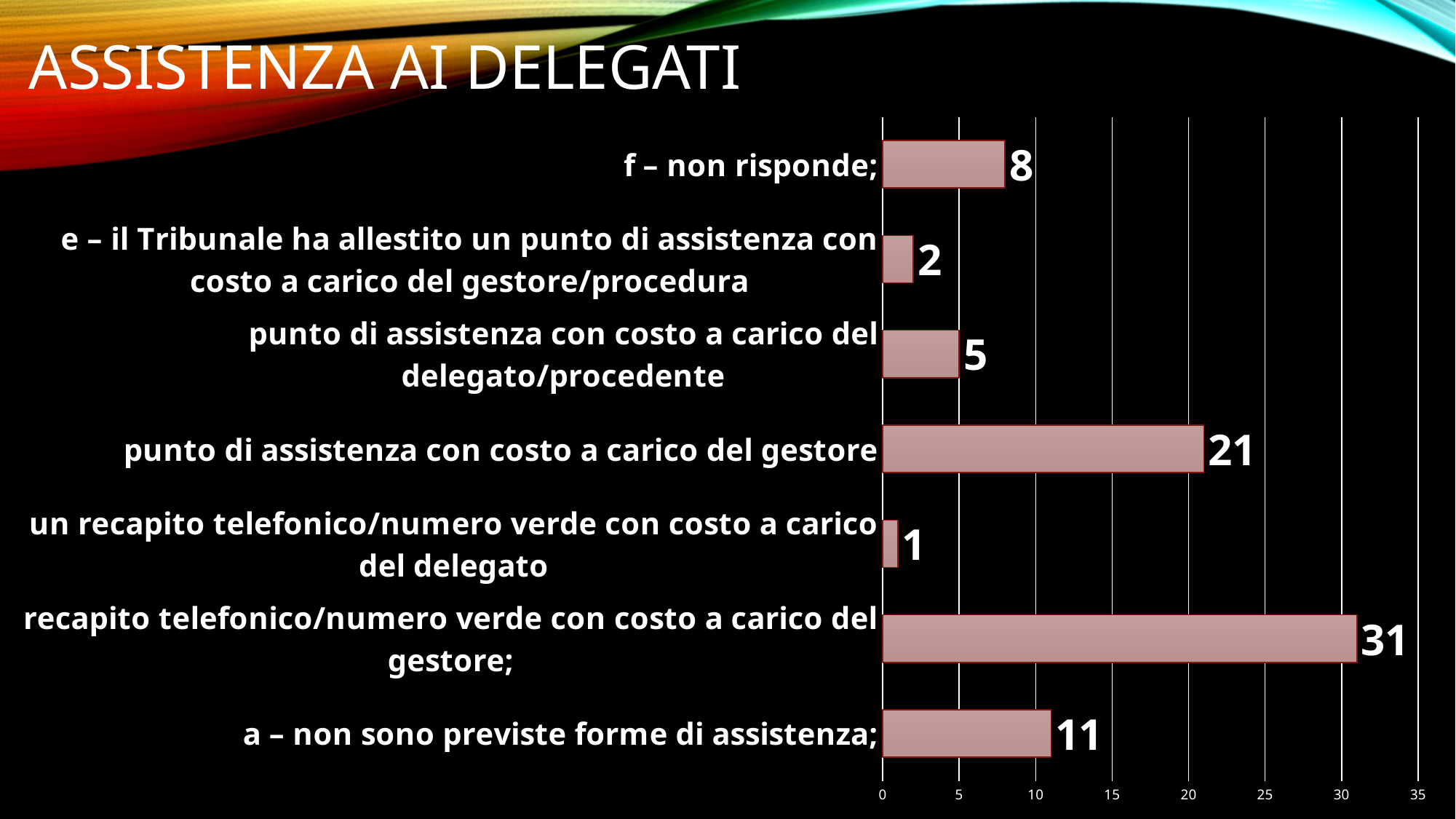
What is the difference between the value for "recapito telefonico/numero verde con costo a carico del gestore;" and the value for "punto di assistenza con costo a carico del gestore"? 10 What is the value for "punto di assistenza con costo a carico del gestore"? 21 What is the value for "f – non risponde;"? 8 What is the title of the slide? ASSISTENZA AI DELEGATI Which category has the lowest value? un recapito telefonico/numero verde con costo a carico del delegato Which is larger: the value for "f – non risponde;" or the value for "punto di assistenza con costo a carico del delegato/procedente"? f – non risponde; How many categories are shown in the chart? 7 What kind of chart is shown on the slide? bar chart Is the value for "a – non sono previste forme di assistenza;" greater or less than 10? greater Which category has the highest value? recapito telefonico/numero verde con costo a carico del gestore; What is the value for "un recapito telefonico/numero verde con costo a carico del delegato"? 1 What is the value for "a – non sono previste forme di assistenza;"? 11